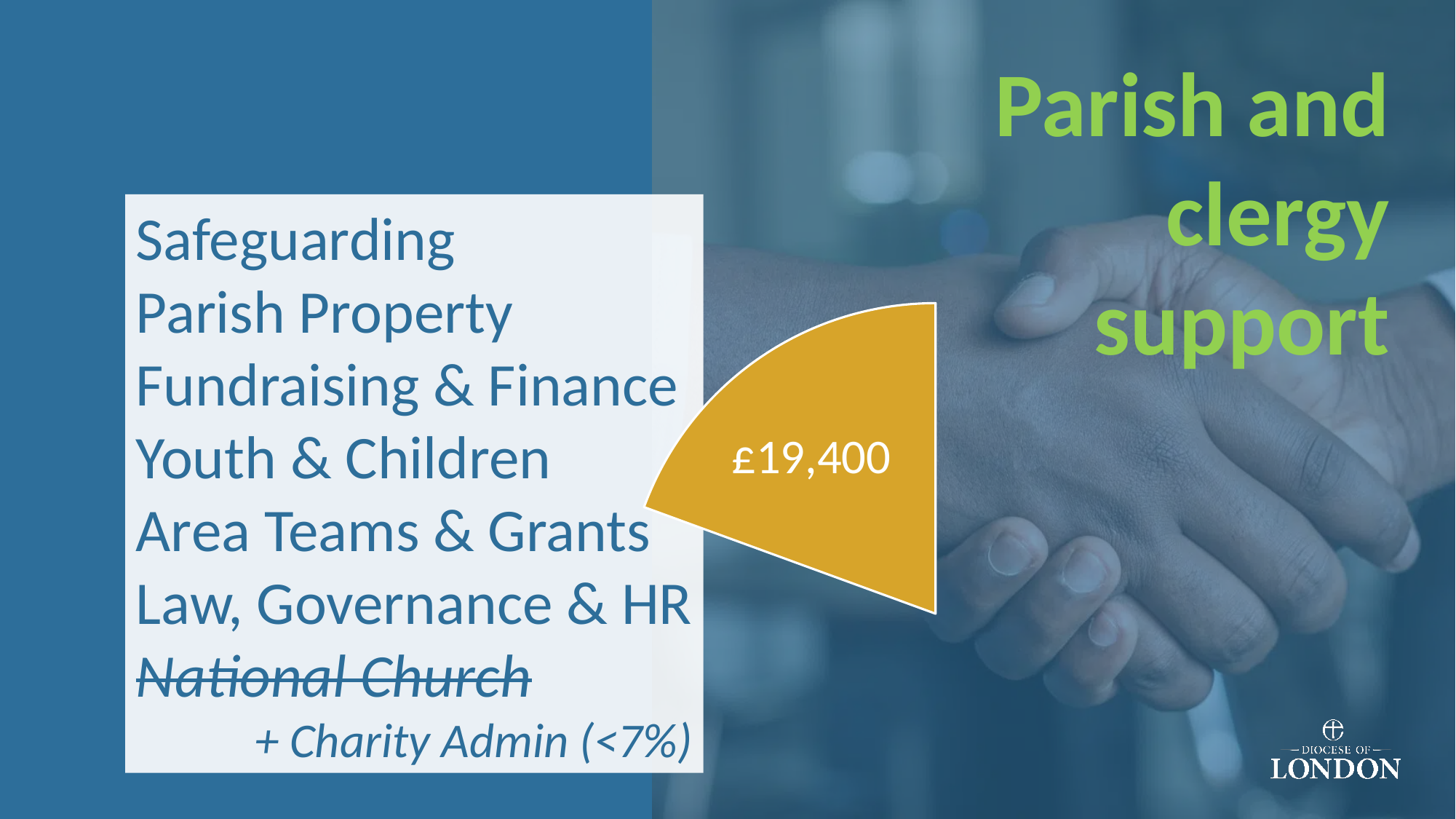
What value is printed on the pie slice shown on the slide? £19,400 How many pie slices are visible on the slide? 1 Is the value shown on the pie slice greater or less than £10,000? greater What colour is the pie slice labelled £19,400? gold What kind of chart is the gold shape with the £19,400 label part of? pie chart What is the title shown in green on the slide next to the pie slice? Parish and clergy support